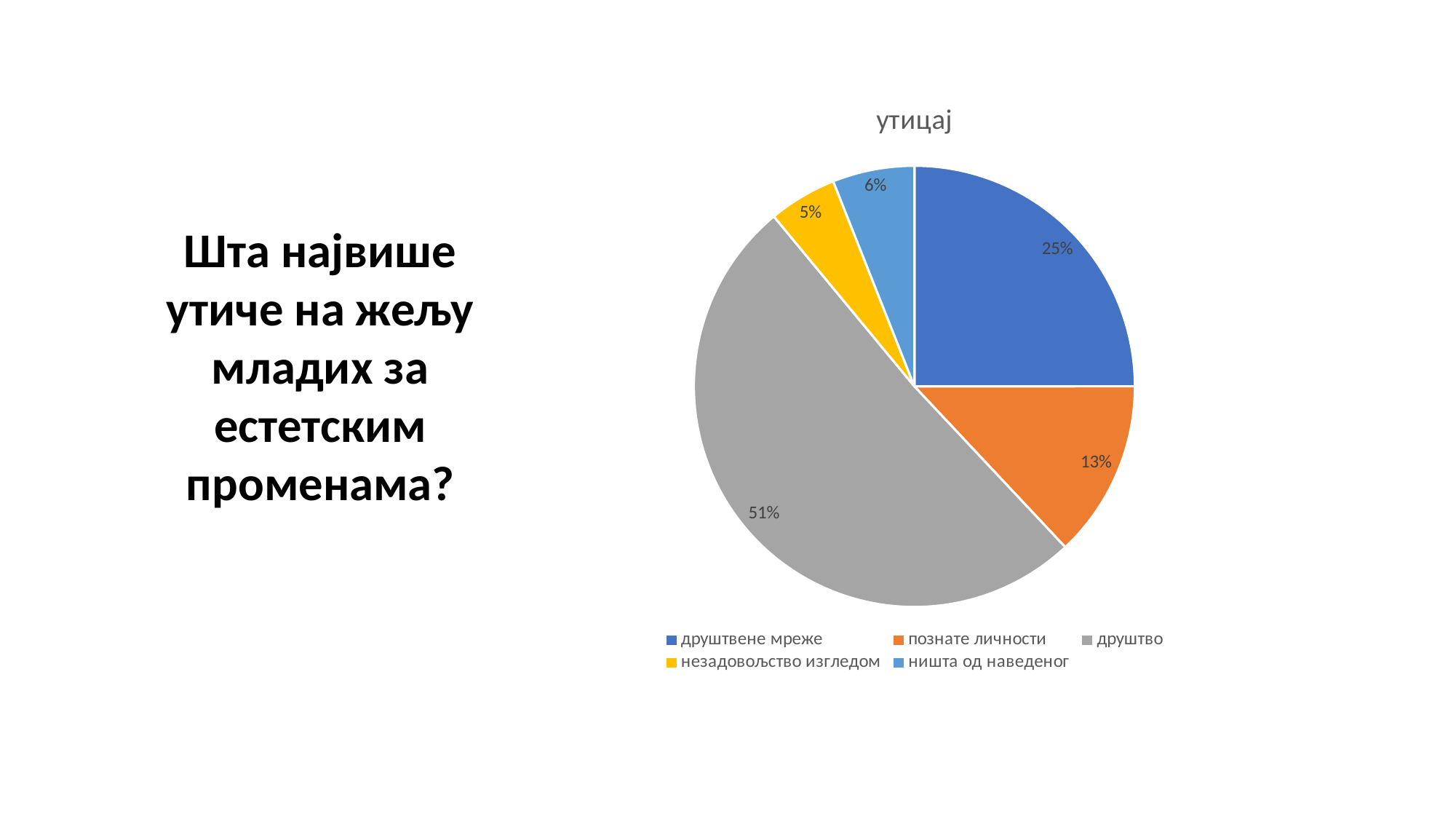
What share of the pie does друштво take? 51% Which is larger, друштвене мреже or познате личности? друштвене мреже What is the value for незадовољство изгледом? 5% What is the value for друштвене мреже? 25% What is the difference between the values for друштво and друштвене мреже? 26% How many categories does the legend list? 5 Which category has the largest slice? друштво Which category has the smallest slice? незадовољство изгледом What is the value for познате личности? 13% What is the title of the chart? утицај What is the value for ништа од наведеног? 6% What type of chart is shown on the slide? pie chart